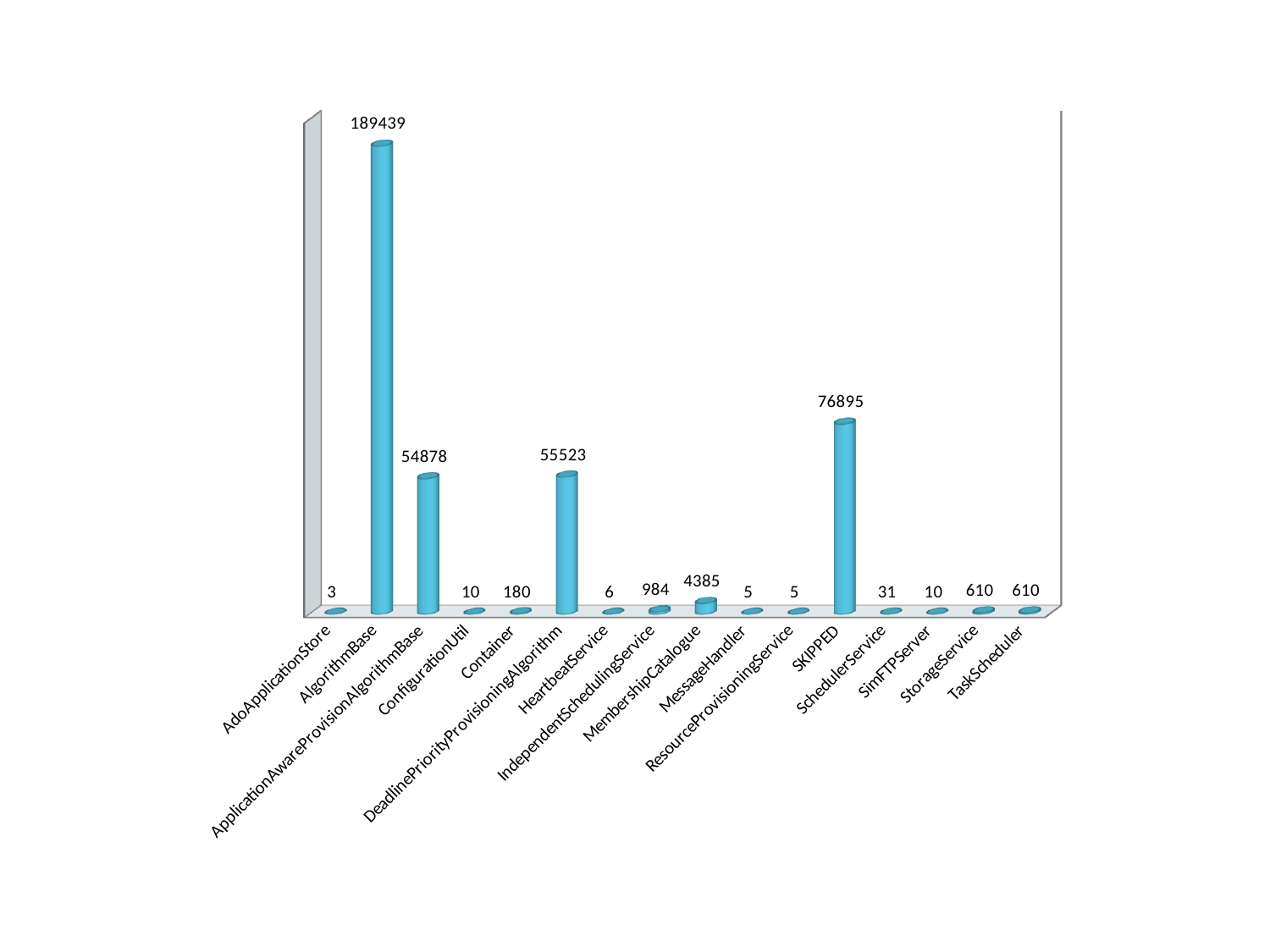
What is the difference between the values for AlgorithmBase and SKIPPED? 112544 Which is larger, the value for SKIPPED or the value for DeadlinePriorityProvisioningAlgorithm? SKIPPED How many categories are shown on the x axis? 16 What kind of chart is shown on the slide? Bar chart What is the difference between the values for DeadlinePriorityProvisioningAlgorithm and ApplicationAwareProvisionAlgorithmBase? 645 Which category has the lowest value? AdoApplicationStore What is the value for Container? 180 Which category has the highest value? AlgorithmBase What is the value for MembershipCatalogue? 4385 What is the value for IndependentSchedulingService? 984 What is the value for SKIPPED? 76895 What is the value for AlgorithmBase? 189439